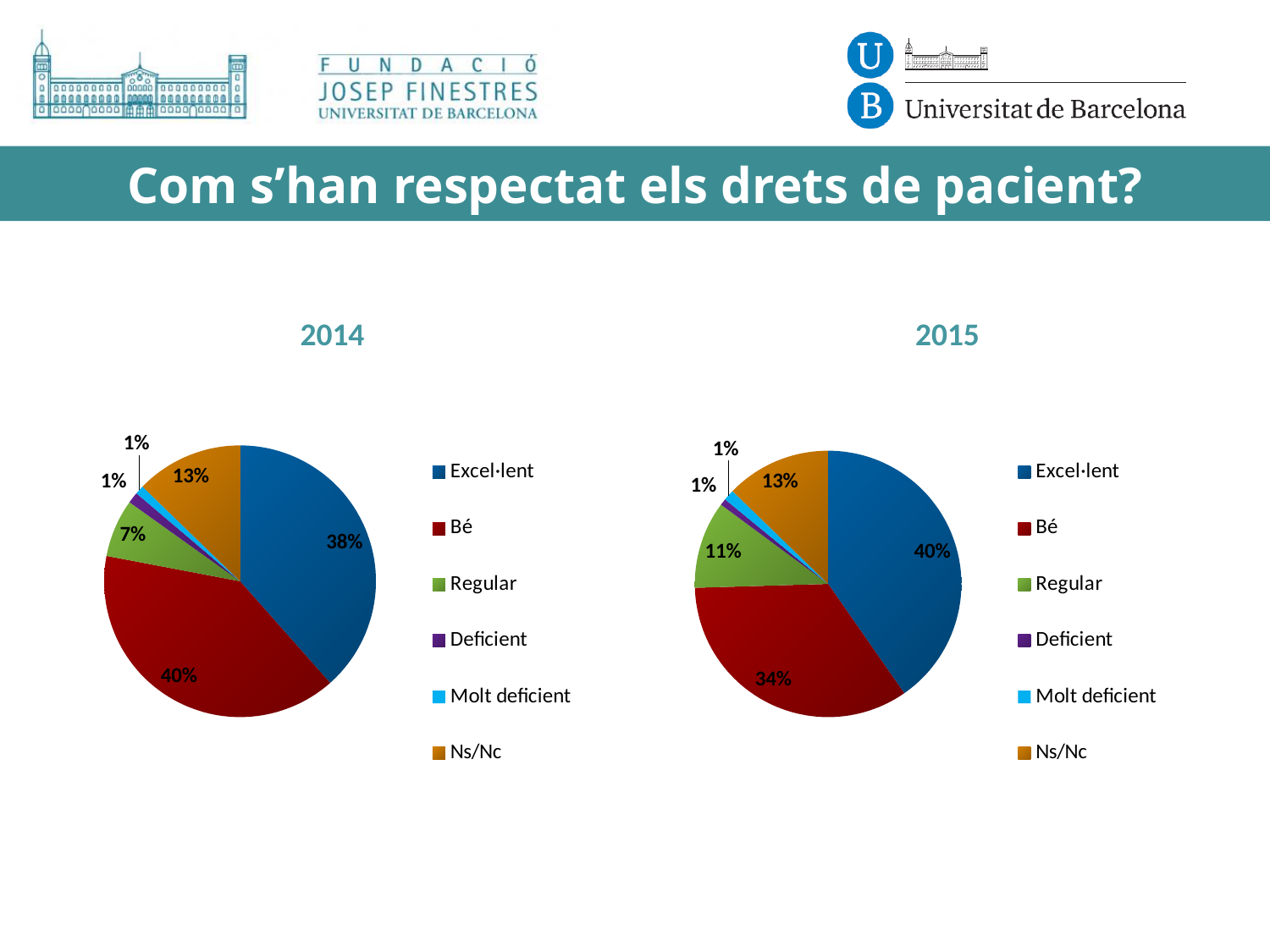
In the 2015 chart, which category has the largest slice? Excel·lent In the 2015 chart, what is the difference between the Excel·lent share and the Bé share? 6% In the 2014 chart, what share is labelled for Excel·lent? 38% Which is larger: the Regular share in 2014 or the Regular share in 2015? 2015 In the 2015 chart, what share is labelled for Ns/Nc? 13% In the 2015 chart, what share is labelled for Regular? 11% In the 2014 chart, what share is labelled for Bé? 40% How many categories does the legend of the 2015 chart list? 6 In the 2014 chart, what is the difference between the Bé share and the Regular share? 33% What type of chart is used for the 2014 data? Pie chart In the 2015 chart, what colour is the Bé slice? Red In the 2014 chart, which category has the largest slice? Bé